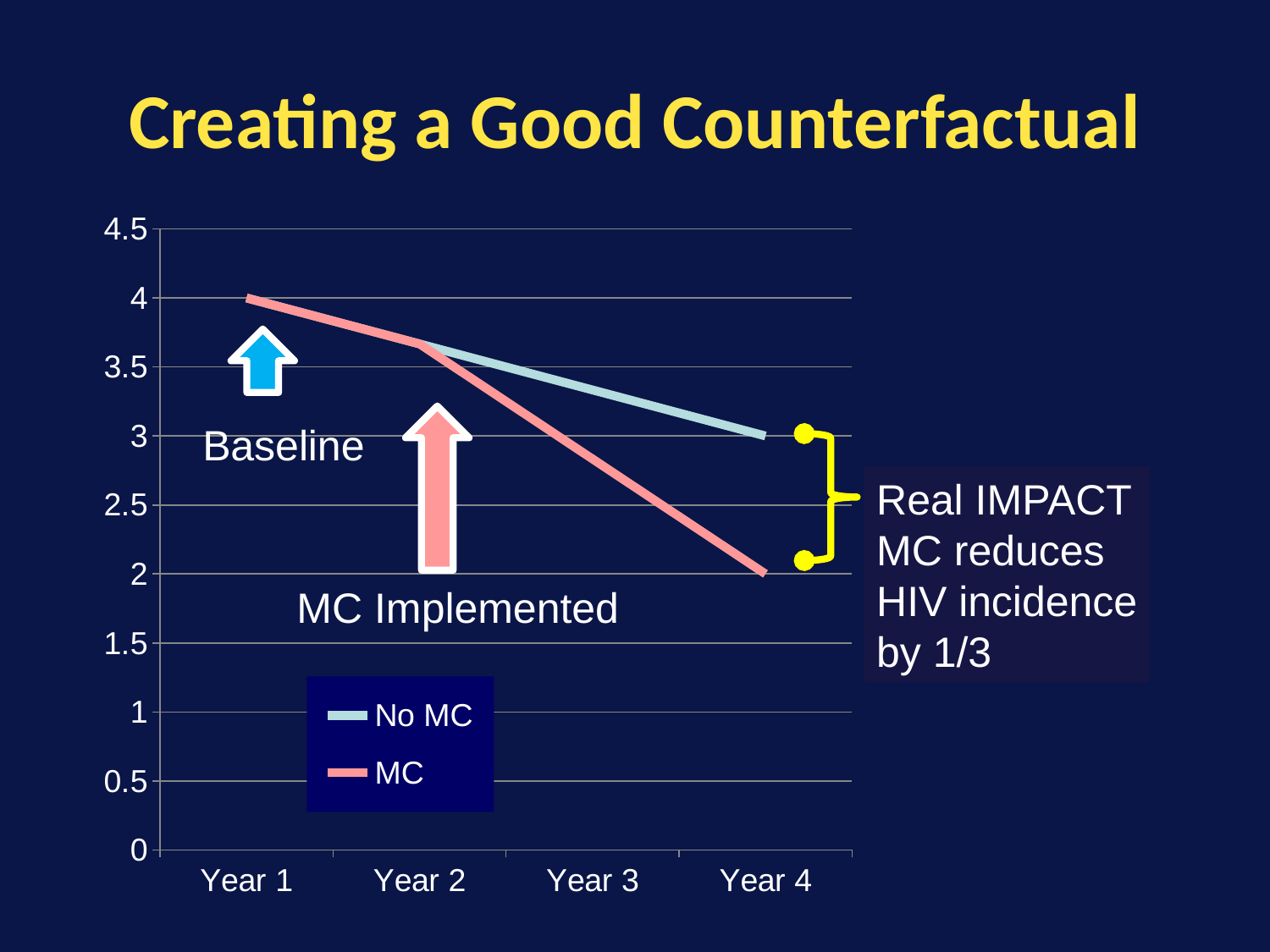
How many series does the legend list? 2 What kind of chart is shown on the slide? line chart What is the title of the slide? Creating a Good Counterfactual How many years are shown on the x axis? 4 Is the value of the MC line at Year 3 greater or less than 3? less What is the difference between the No MC and MC values at Year 4? 1 Do the values of the MC line rise or fall from Year 1 to Year 4? fall At Year 4, which series has the higher value, No MC or MC? No MC What is the value of the MC line at Year 4? 2 What is the value of the MC line at Year 1? 4 What is the value of the No MC line at Year 4? 3 Is the value of the No MC line at Year 3 greater or less than 3? greater